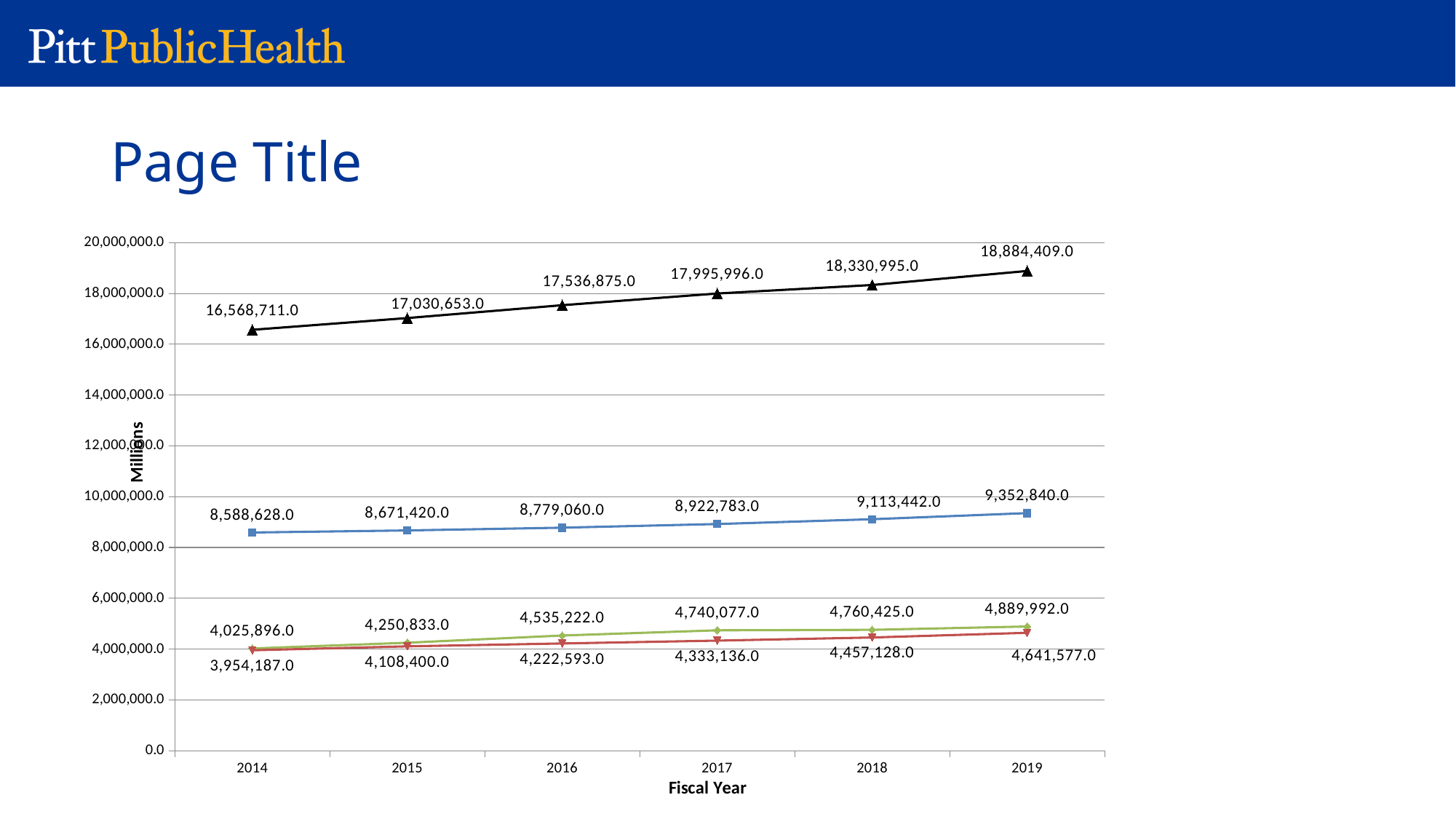
What is the value of the green line for fiscal year 2017? 4,740,077.0 What is the difference between the green line and the red line in fiscal year 2019? 248,415.0 How many fiscal years are shown on the x axis? 6 What type of chart is shown on the slide? Line chart Do the values of the black line rise or fall from 2014 to 2019? Rise In which fiscal year does the blue line have its lowest value? 2014 Which is larger in 2018: the green line value or the red line value? Green line (4,760,425.0) What is the value of the red line for fiscal year 2014? 3,954,187.0 What is the value of the blue line (square markers) for fiscal year 2016? 8,779,060.0 In which fiscal year does the black line reach its highest value? 2019 By how much did the black line increase from 2014 to 2019? 2,315,698.0 What is the value of the black line (triangle markers) for fiscal year 2019? 18,884,409.0